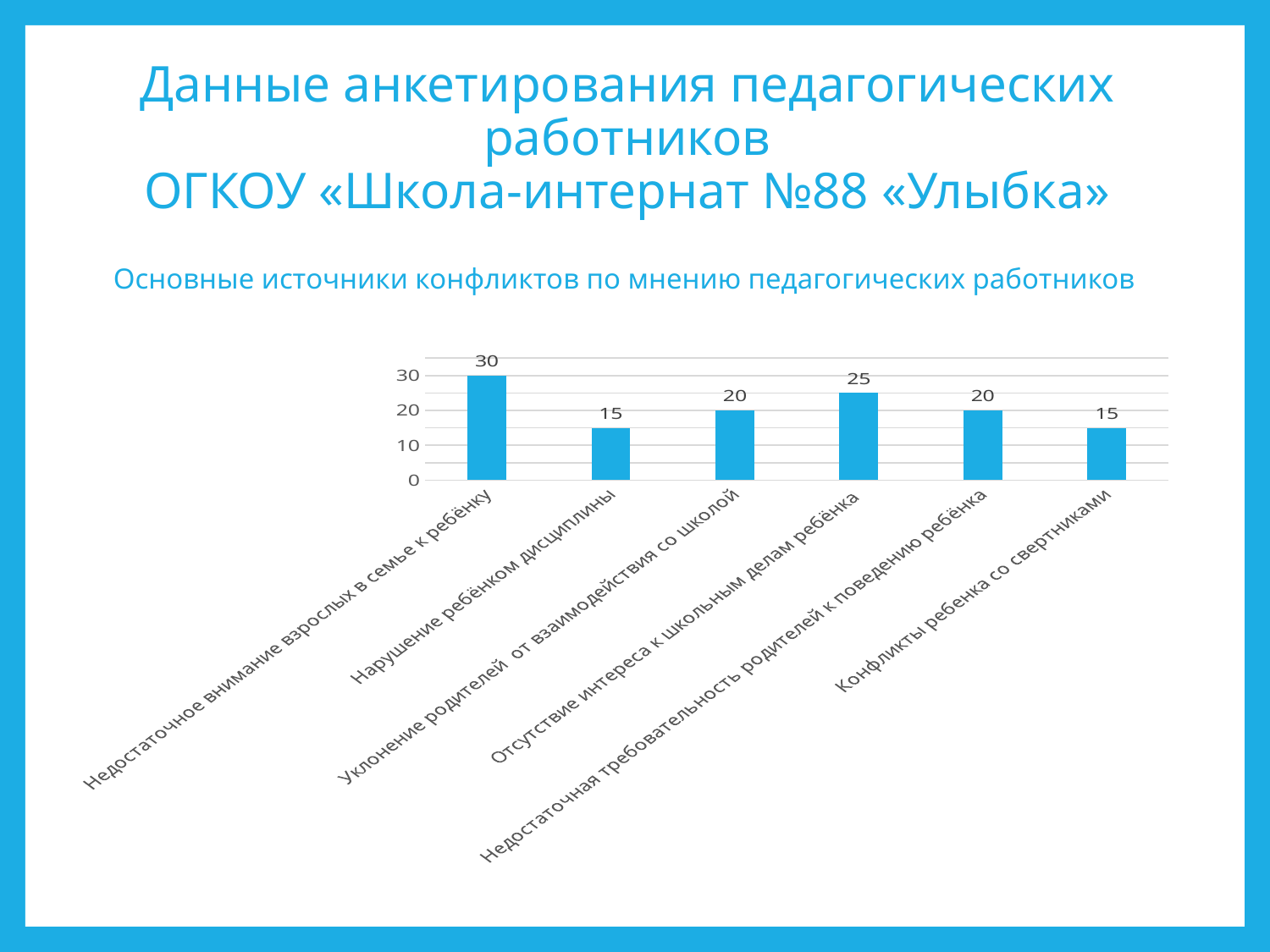
What is the difference between the values for «Недостаточное внимание взрослых в семье к ребёнку» and «Конфликты ребенка со сверстниками»? 15 How many categories are shown in the chart? 6 What value is shown for «Уклонение родителей от взаимодействия со школой»? 20 What is the subtitle above the chart? Основные источники конфликтов по мнению педагогических работников What value is shown for «Отсутствие интереса к школьным делам ребёнка»? 25 What is the difference between the values for «Отсутствие интереса к школьным делам ребёнка» and «Нарушение ребёнком дисциплины»? 10 Which is larger: the value for «Отсутствие интереса к школьным делам ребёнка» or the value for «Недостаточная требовательность родителей к поведению ребёнка»? Отсутствие интереса к школьным делам ребёнка What value is shown for «Недостаточное внимание взрослых в семье к ребёнку»? 30 What kind of chart is shown on the slide? Bar chart How many categories have a value of 20? 2 Which category has the highest value? Недостаточное внимание взрослых в семье к ребёнку What value is shown for «Нарушение ребёнком дисциплины»? 15